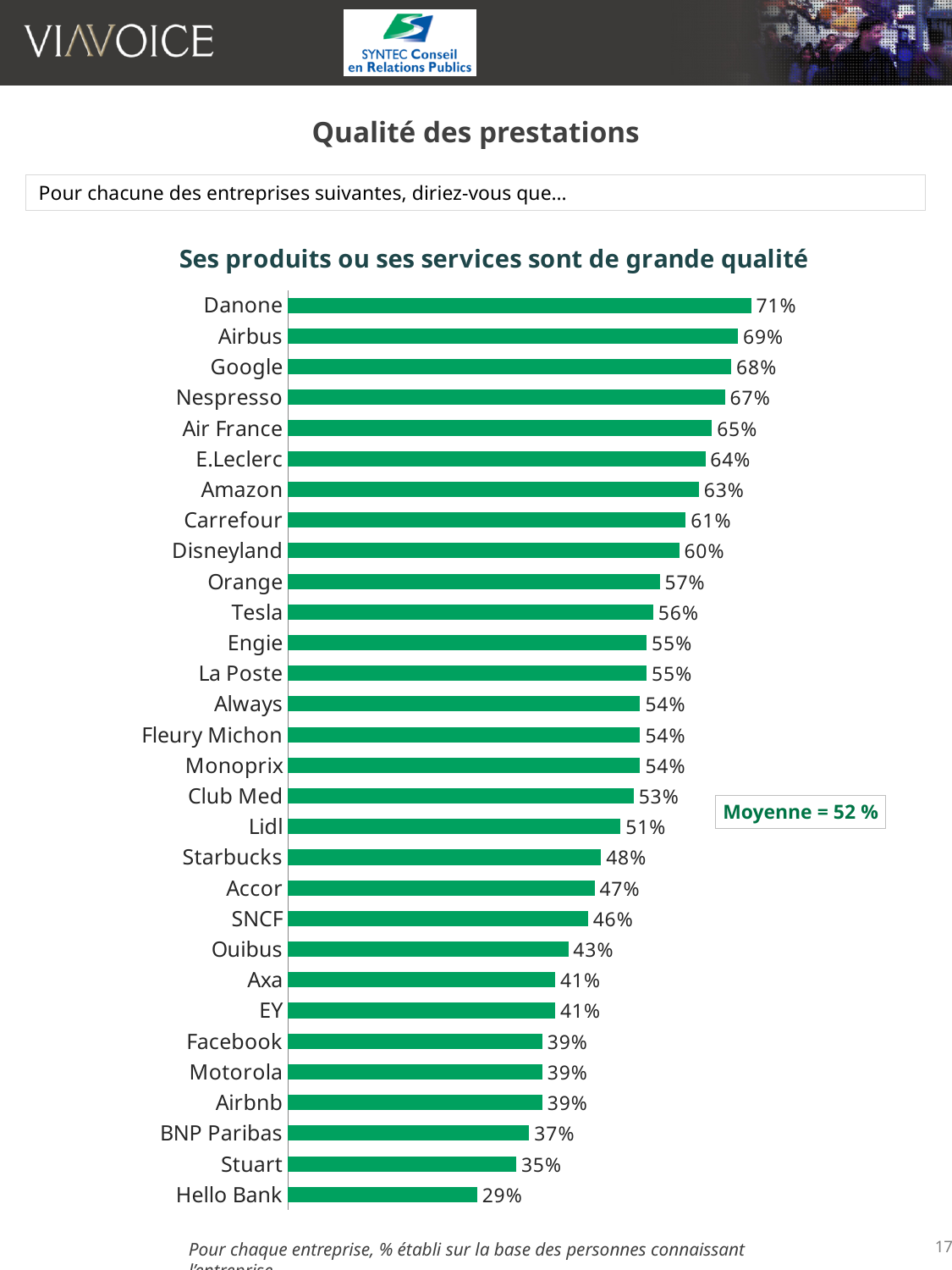
Which company has the highest value? Danone What is the difference between the values for Airbus and Airbnb? 30% What is the value for Tesla? 56% What is the average (Moyenne) value indicated on the chart? 52 % What is the value for Danone? 71% Which company has the lowest value? Hello Bank What is the difference between the values for Google and Starbucks? 20% What is the value for Hello Bank? 29% What kind of chart is shown on the slide? Bar chart What is the title of the chart? Ses produits ou ses services sont de grande qualité How many companies are shown in the chart? 30 Which has a larger value, Carrefour or Lidl? Carrefour